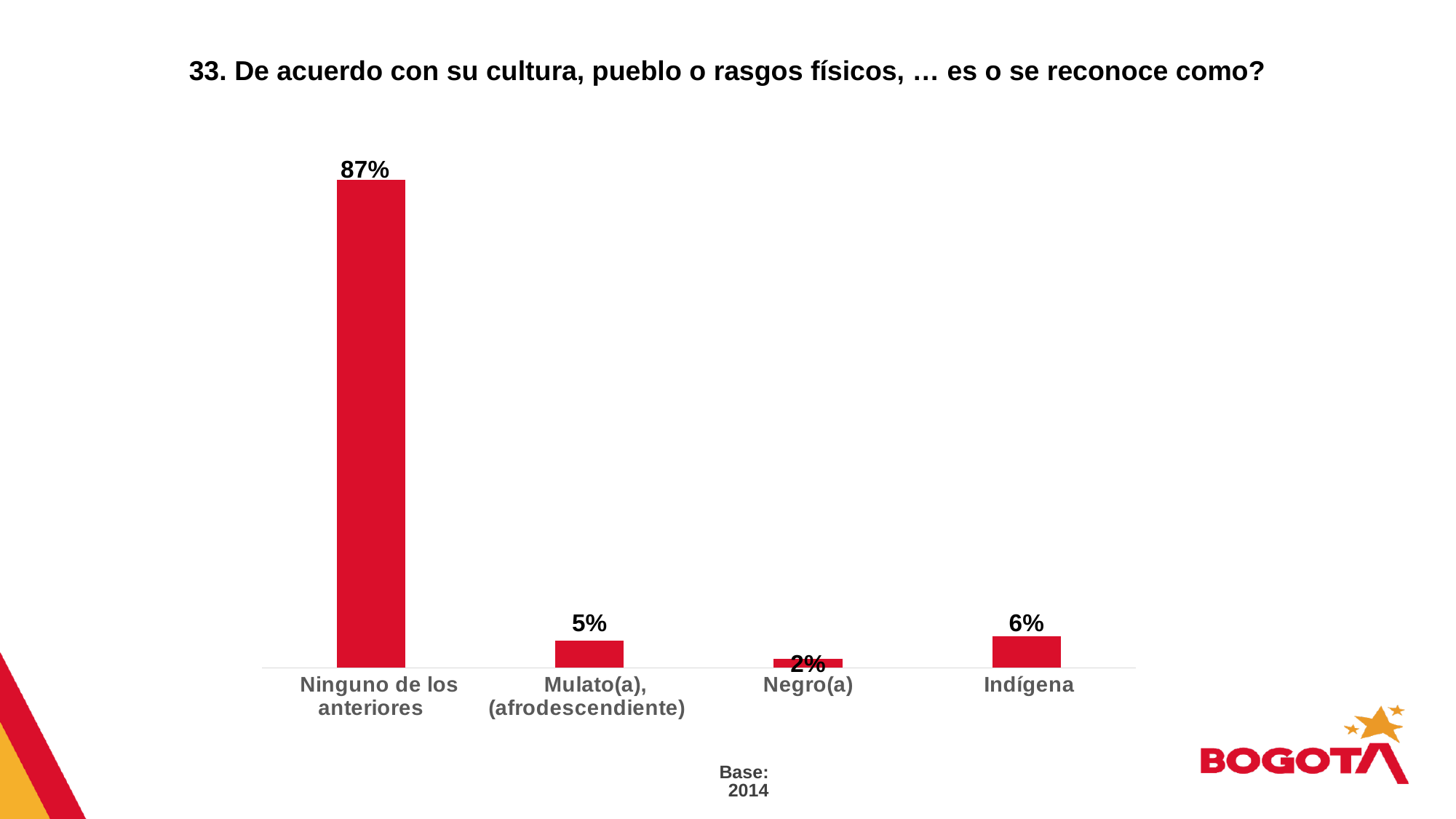
Which category has the highest value? Ninguno de los anteriores What is the value for "Mulato(a), (afrodescendiente)"? 5% Which category has the lowest value? Negro(a) What is the value for "Negro(a)"? 2% How many categories are shown in the chart? 4 What base year is shown below the chart? 2014 What is the value for "Ninguno de los anteriores"? 87% What is the difference between the values for "Ninguno de los anteriores" and "Indígena"? 81% What kind of chart is shown on the slide? Bar chart What is the value for "Indígena"? 6% Which is larger, the value for "Indígena" or the value for "Mulato(a), (afrodescendiente)"? Indígena What is the difference between the values for "Indígena" and "Negro(a)"? 4%